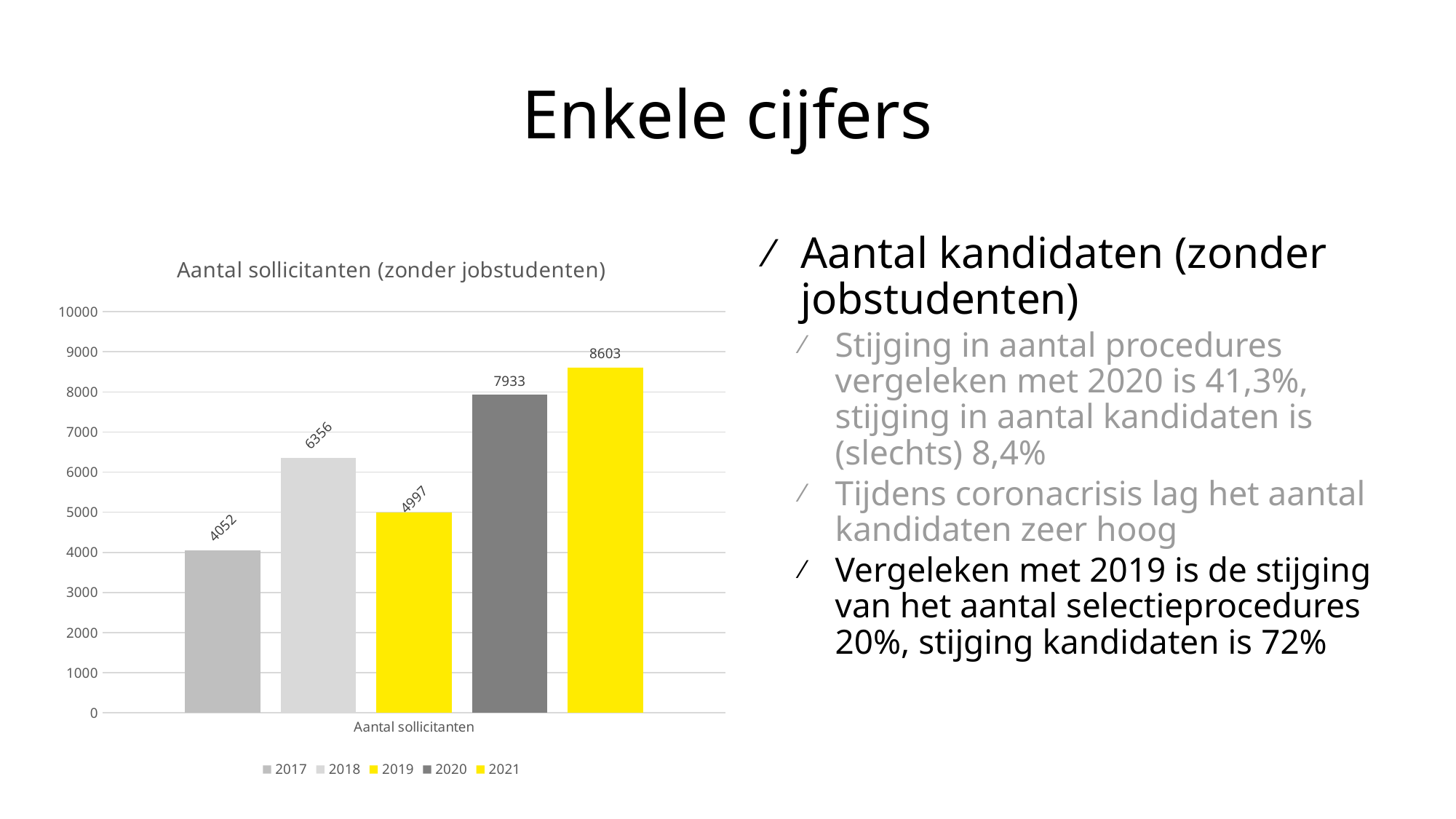
Which year has the highest number of sollicitanten? 2021 What is the difference between the values for 2021 and 2020? 670 What is the value for 2021 in the chart? 8603 How many series does the legend list? 5 Which is larger, the value for 2018 or the value for 2019? 2018 What is the value for 2019 in the chart? 4997 Is the value for 2020 greater or less than 7000? greater What kind of chart is shown on the slide? bar chart What is the value for 2017 in the chart? 4052 What is the difference between the values for 2018 and 2019? 1359 What is the title of the chart? Aantal sollicitanten (zonder jobstudenten) Which year has the lowest number of sollicitanten? 2017